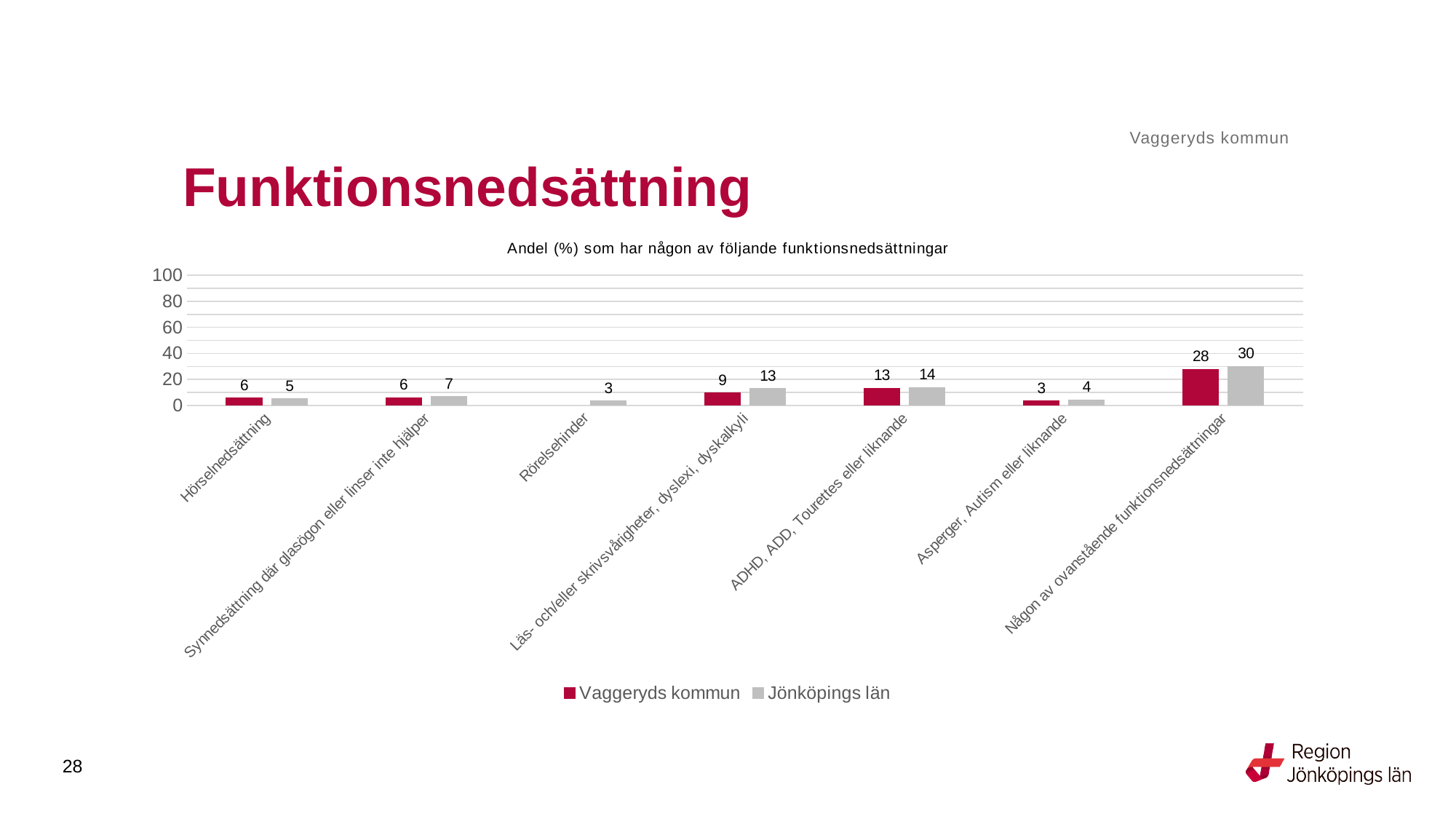
What is the difference between Jönköpings län and Vaggeryds kommun for Någon av ovanstående funktionsnedsättningar? 2 Is the value for Vaggeryds kommun for Någon av ovanstående funktionsnedsättningar greater or less than 40? less What is the value for Jönköpings län for Läs- och/eller skrivsvårigheter, dyslexi, dyskalkyli? 13 For ADHD, ADD, Tourettes eller liknande, which series has the larger value, Vaggeryds kommun or Jönköpings län? Jönköpings län What type of chart is shown on the slide? bar chart What is the value for Jönköpings län for Rörelsehinder? 3 Which category has the highest value for Vaggeryds kommun? Någon av ovanstående funktionsnedsättningar How many categories are shown on the x axis? 7 What is the value for Vaggeryds kommun for Hörselnedsättning? 6 How many series does the legend list? 2 Which category has the lowest value for Jönköpings län? Rörelsehinder What is the title of the chart? Andel (%) som har någon av följande funktionsnedsättningar